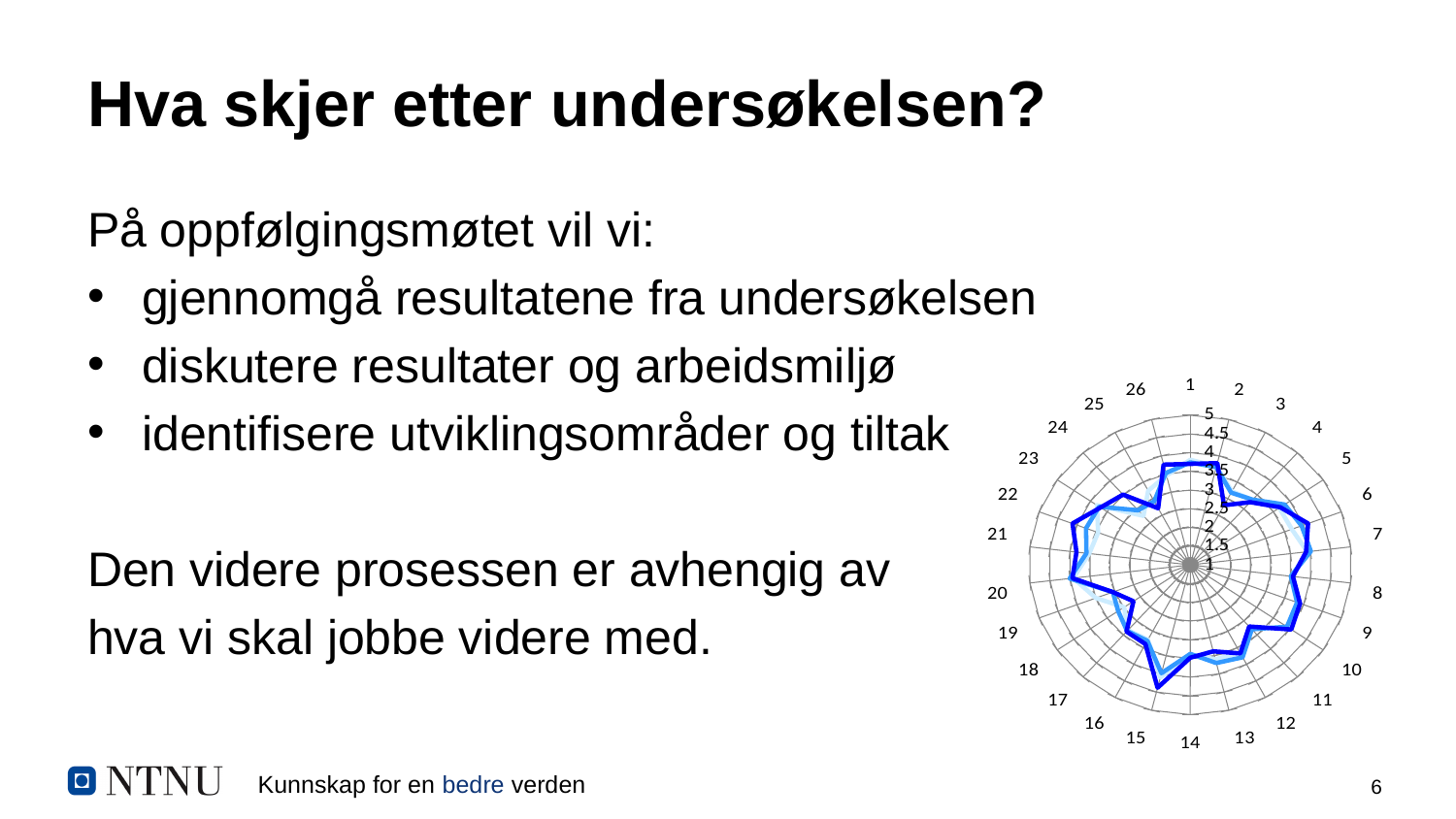
What is the highest value shown on the radial axis of the radar chart? 5 Is the dark blue line's value for category 15 greater or less than 3? greater Is the dark blue line's value for category 1 greater or less than 3? greater How many categories are plotted around the radar chart? 26 Is the dark blue line's value for category 7 greater or less than 3? greater What is the lowest value shown on the radial axis of the radar chart? 1 What kind of chart is shown on the slide? Radar chart How many data series (lines) are plotted on the radar chart? 3